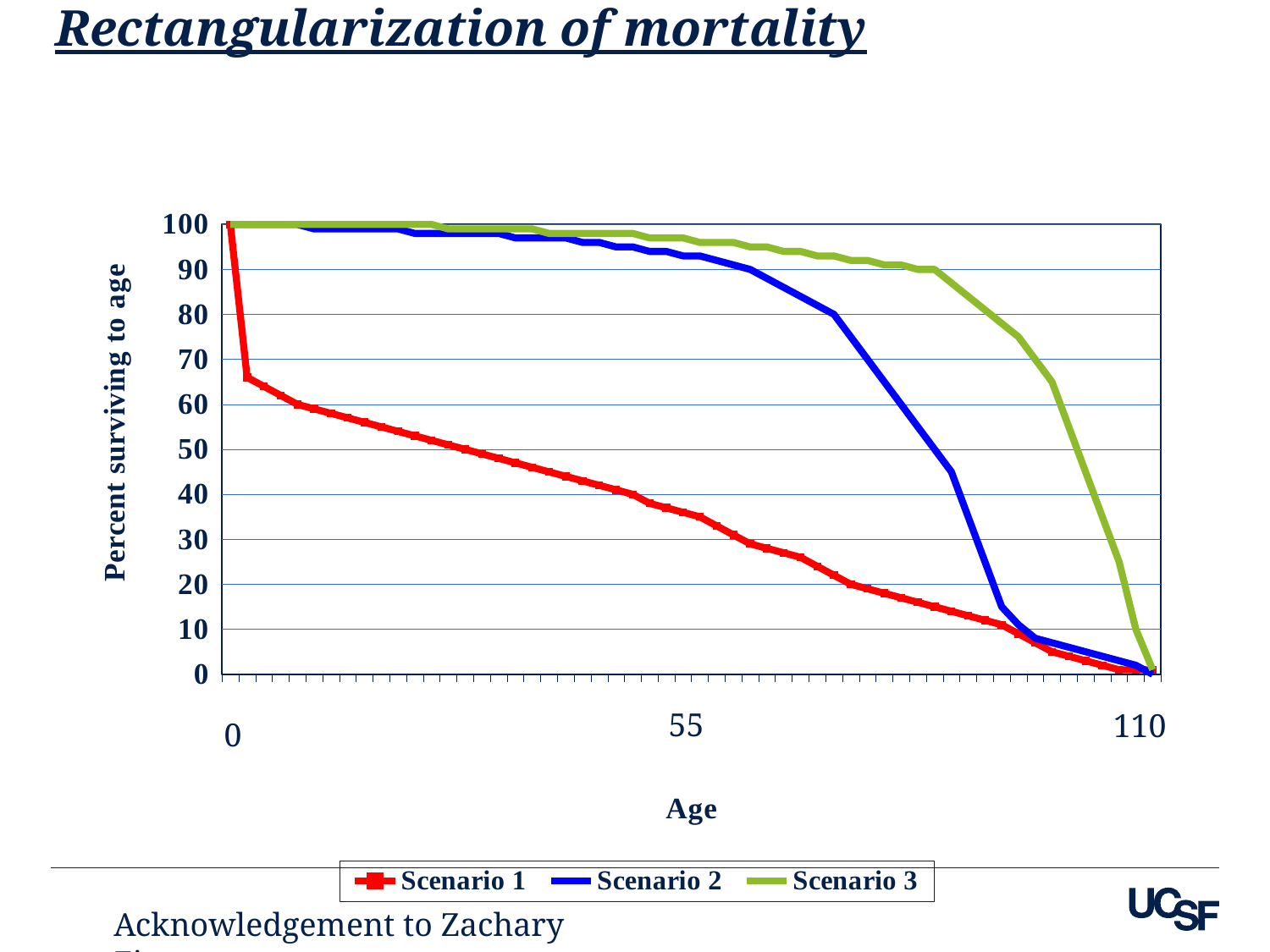
Which scenario has the lowest percent surviving at age 55? Scenario 1 What is the highest age shown on the x axis? 110 Is the value for Scenario 1 at age 55 greater or less than 40? less What kind of chart is shown on the slide? line chart What is the title of the chart on the slide? Rectangularization of mortality How many series does the legend list? 3 At age 55, which is larger: the value for Scenario 1 or the value for Scenario 2? Scenario 2 Is the value for Scenario 2 at age 55 greater or less than 80? greater Do the values for Scenario 1 rise or fall as age increases? fall Is the value for Scenario 3 at age 55 greater or less than 90? greater Which series is drawn in red? Scenario 1